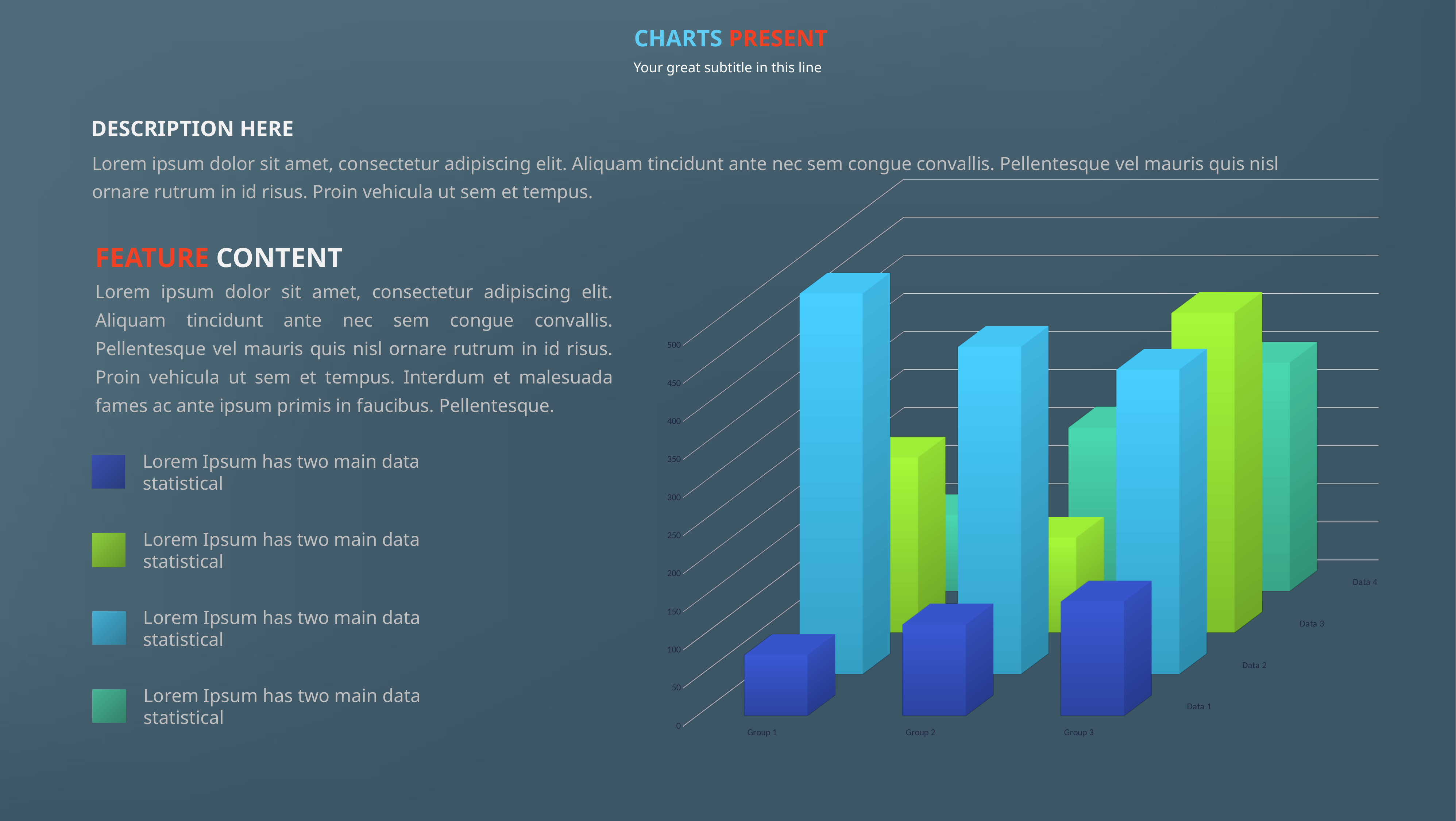
What kind of chart is shown on the slide? bar chart Is the value for Data 1 in Group 3 greater or less than 100? greater Is the value for Data 1 in Group 1 greater or less than 150? less Which group has the highest value for Data 2? Group 1 Is the value for Data 2 in Group 2 greater or less than 300? greater How many data series (Data 1 to Data 4) does the chart show? 4 How many groups are labelled along the x axis of the chart? 3 Do the Data 1 values rise or fall from Group 1 to Group 3? rise Which group has the lowest value for Data 1? Group 1 For Data 3, which is larger: Group 1 or Group 3? Group 3